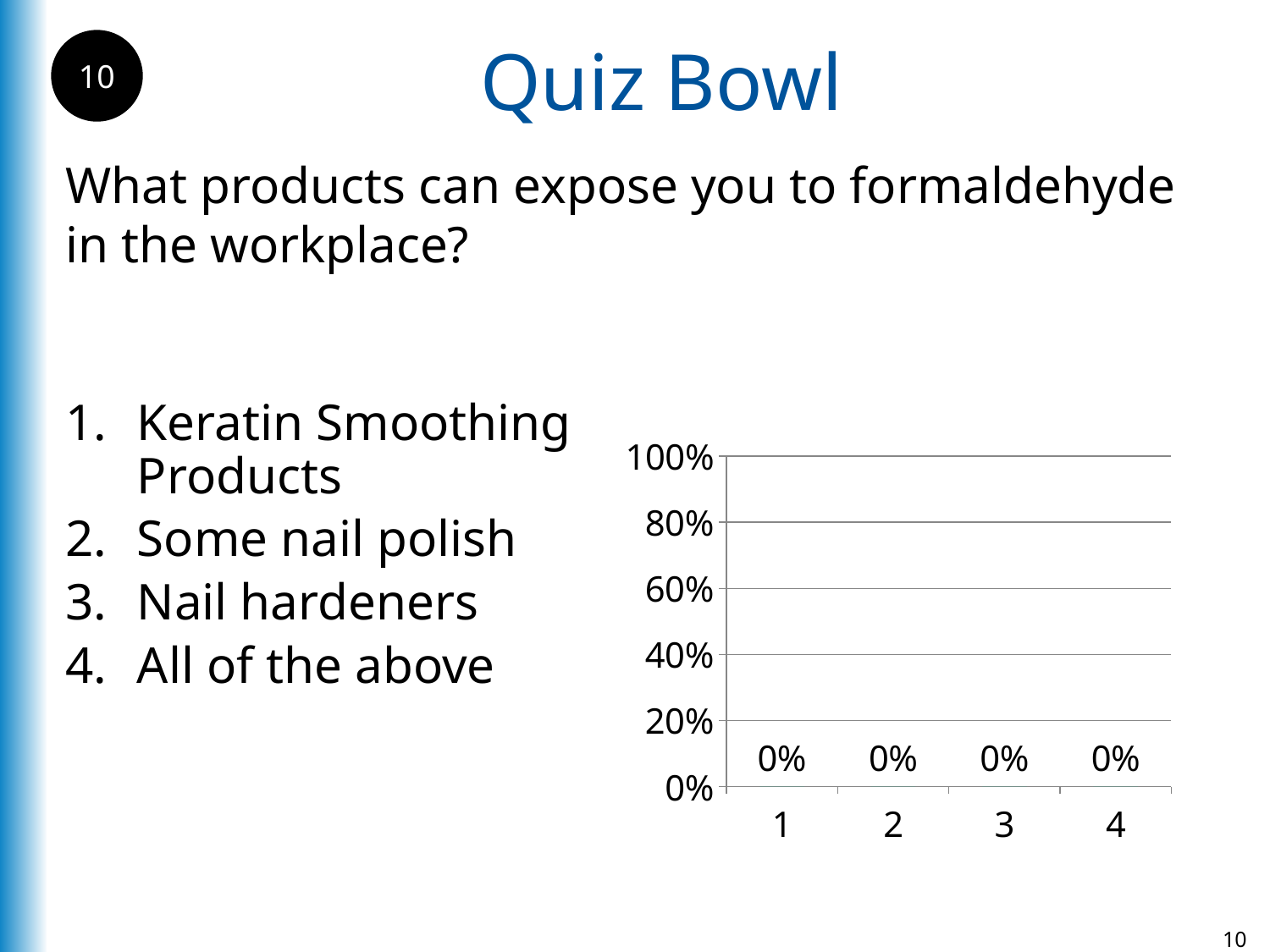
What is the highest value labelled on the chart's vertical axis? 100% Is the value for category 3 greater or less than 40%? less What value is shown for category 4 on the chart? 0% What is the difference between the values for category 1 and category 4? 0% What value is shown for category 2 on the chart? 0% Is the value for category 2 greater or less than 20%? less What is the interval between tick labels on the chart's vertical axis? 20% What value is shown for category 1 on the chart? 0% What value is shown for category 3 on the chart? 0% How many categories are shown on the x axis of the chart? 4